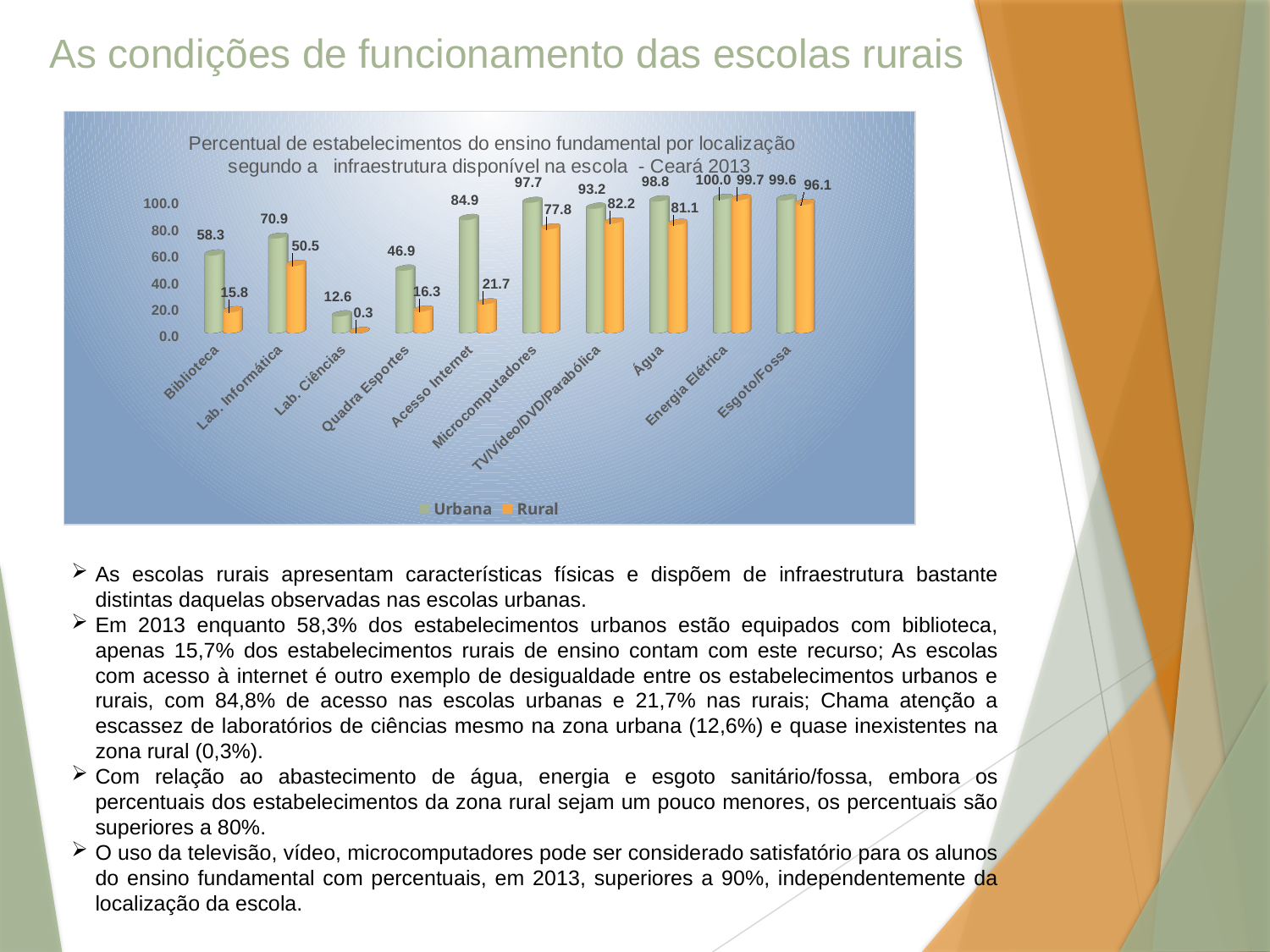
Which category has the highest Urbana value? Energia Elétrica What is the difference between the Urbana and Rural values for Acesso Internet? 63.2 What is the Rural value for Acesso Internet? 21.7 What is the Urbana value for Biblioteca? 58.3 What is the Rural value for Lab. Ciências? 0.3 How many series does the legend list? 2 How many categories are shown on the x axis? 10 What is the Urbana value for Esgoto/Fossa? 99.6 Which is larger, the Rural value for Lab. Informática or the Rural value for Quadra Esportes? Lab. Informática Which series is shown in orange in the legend? Rural Which category has the lowest Rural value? Lab. Ciências What kind of chart is shown on the slide? Bar chart